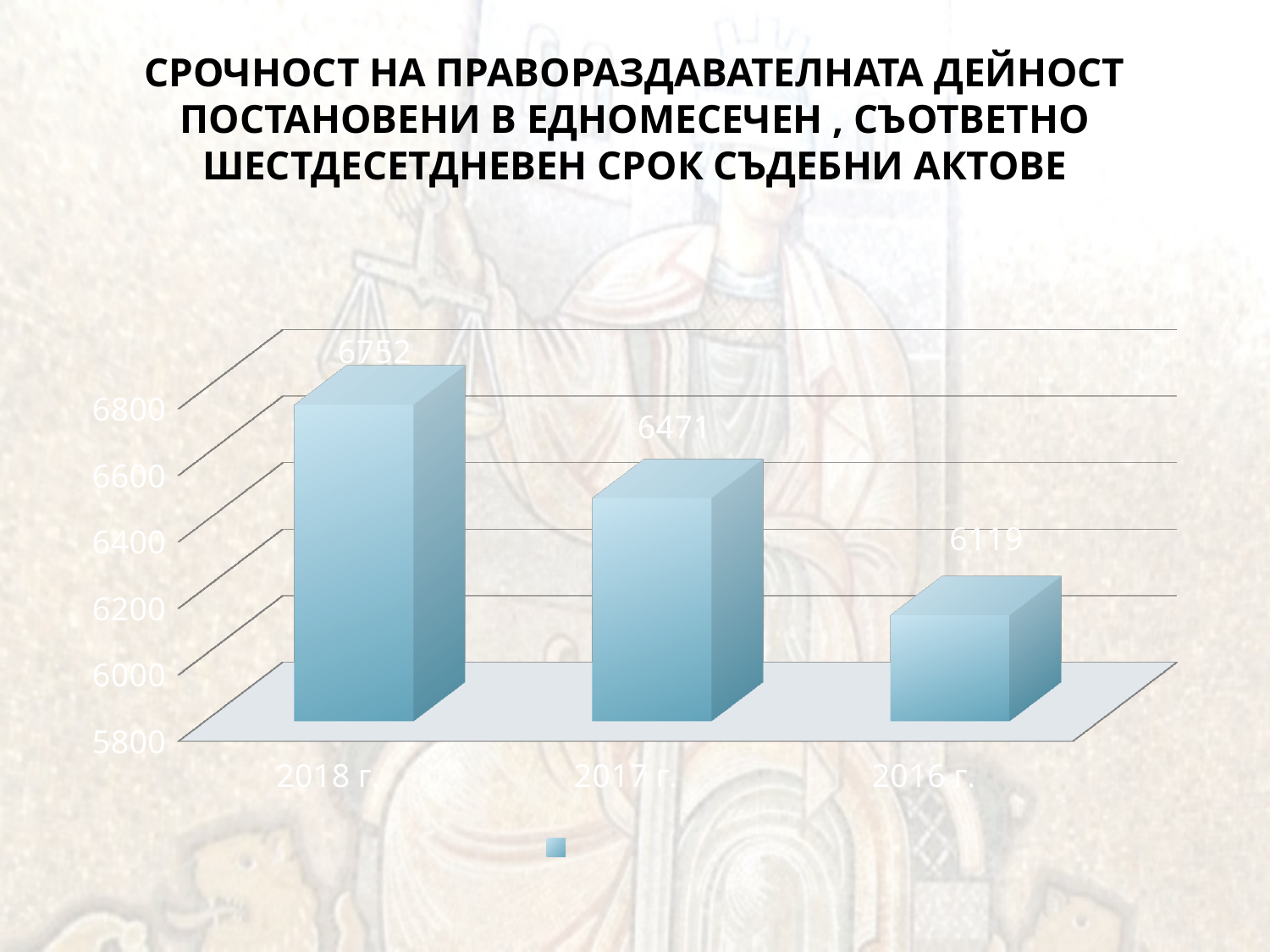
Which year has the highest value? 2018 г. Do the values rise or fall moving from left to right along the x axis? fall What is the value for 2016 г.? 6119 What is the difference between the values for 2018 г. and 2017 г.? 281 Which year has the lowest value? 2016 г. What is the value for 2018 г.? 6752 What is the difference between the values for 2017 г. and 2016 г.? 352 Which is larger, the value for 2017 г. or the value for 2016 г.? 2017 г. Is the value for 2016 г. greater or less than 6200? less What kind of chart is shown on the slide? bar chart How many categories are shown on the x axis? 3 What is the value for 2017 г.? 6471